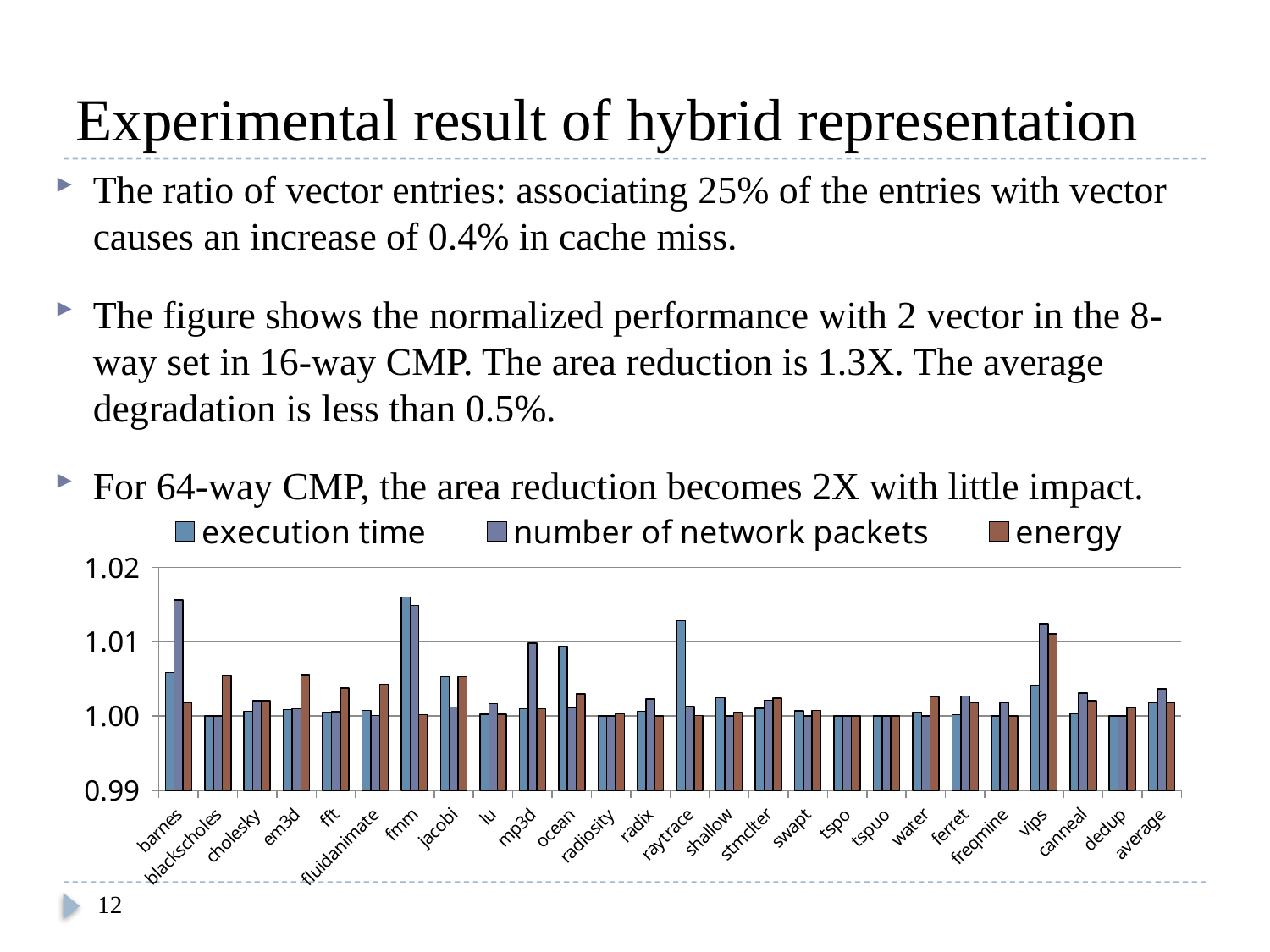
Which is larger for barnes: the execution time bar or the number of network packets bar? number of network packets Is the number of network packets value for barnes greater or less than 1.01? greater How many series does the chart's legend list? 3 Which category has the larger execution time bar, fmm or jacobi? fmm Is the execution time value for fmm greater or less than 1.01? greater What are the three series named in the chart's legend? execution time, number of network packets, energy How many categories are plotted along the x axis of the chart? 26 What kind of chart is shown on the slide? bar chart Which category has the highest execution time bar? fmm Is the execution time value for raytrace greater or less than 1.01? greater Which category has the highest energy bar? vips